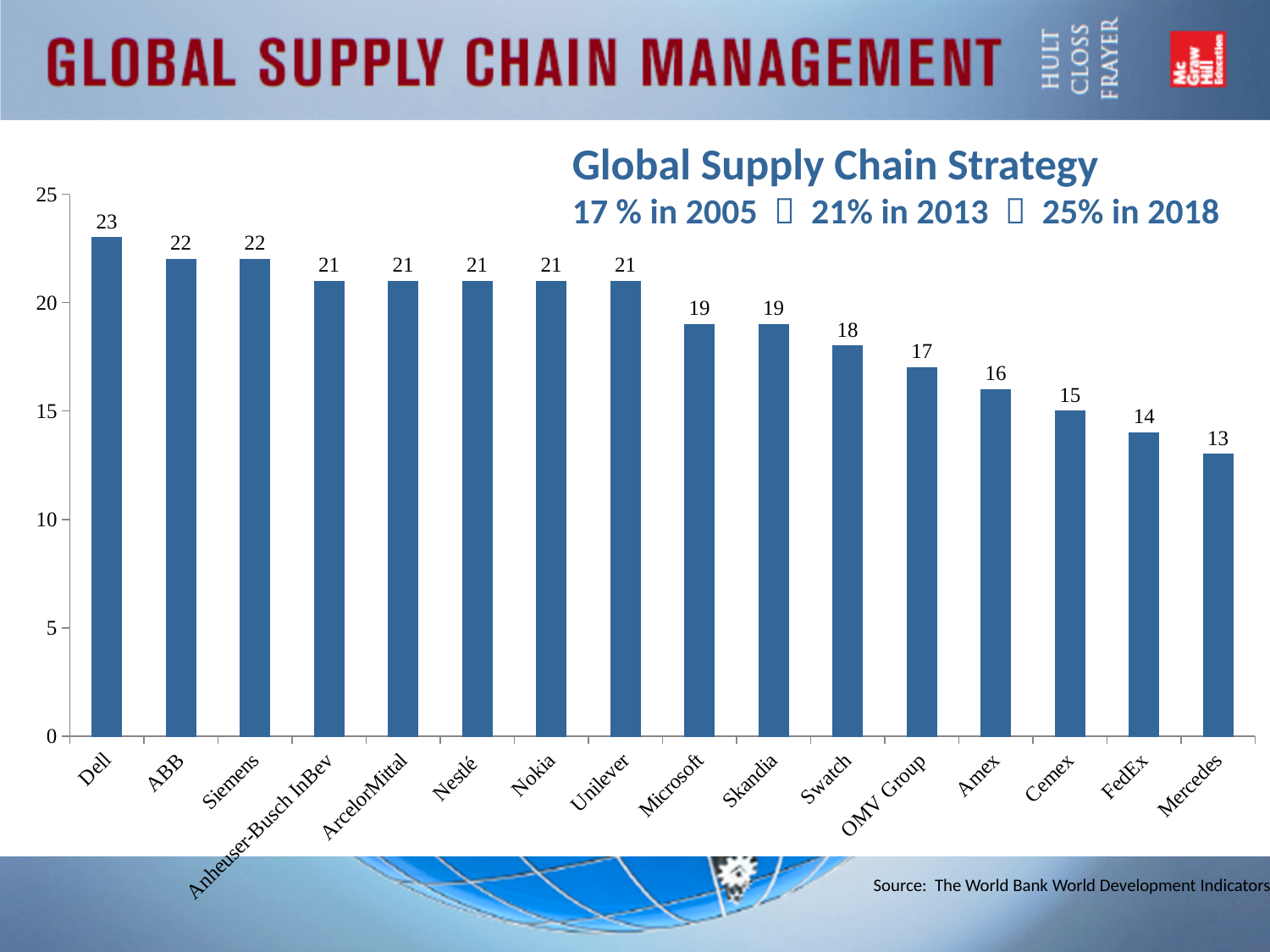
What is the difference between the values for Siemens and Swatch? 4 How many companies are shown on the chart? 16 What kind of chart is shown on the slide? Bar chart Which is larger, the value for Amex or the value for FedEx? Amex Which company has the lowest value? Mercedes Which company has the highest value? Dell What is the value for Mercedes? 13 What is the value for OMV Group? 17 What is the difference between the values for Dell and Mercedes? 10 What is the value for Dell? 23 Do the values rise or fall from left to right along the x axis? Fall What is the value for Microsoft? 19